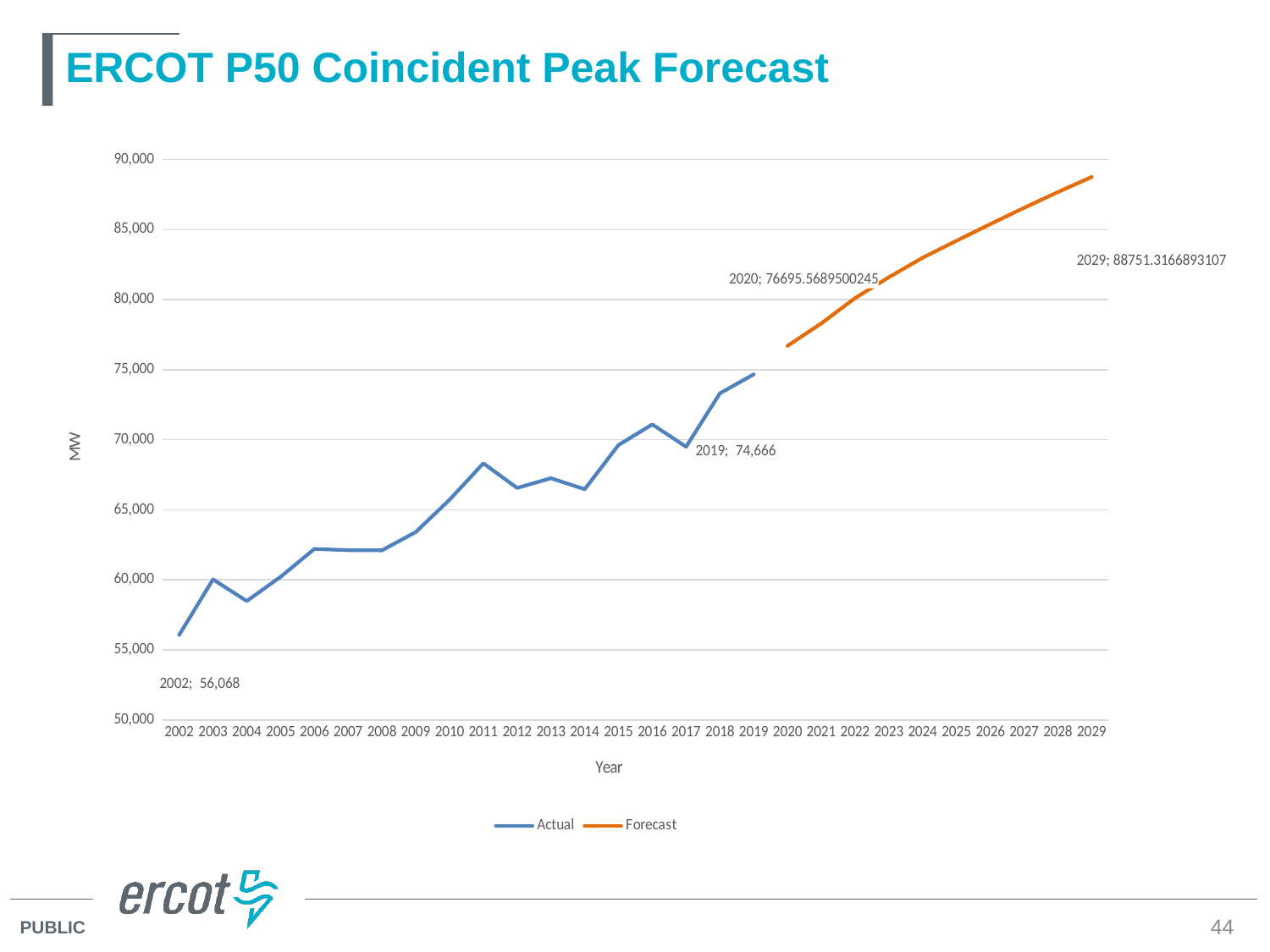
What is the difference between the 2019 actual value and the 2002 actual value? 18,598 Which year has the highest value on the chart? 2029 What kind of chart is shown on the slide? line chart Which is larger, the Actual value for 2016 or for 2017? 2016 How many series does the legend list? 2 What are the two legend entries on the chart? Actual and Forecast What is the value for 2019 on the Actual series? 74,666 What is the forecast value labelled for 2020? 76695.5689500245 Which year has the lowest value on the chart? 2002 Is the Actual value for 2011 greater or less than 65,000? greater What is the forecast value labelled for 2029? 88751.3166893107 What is the value for 2002 on the Actual series? 56,068